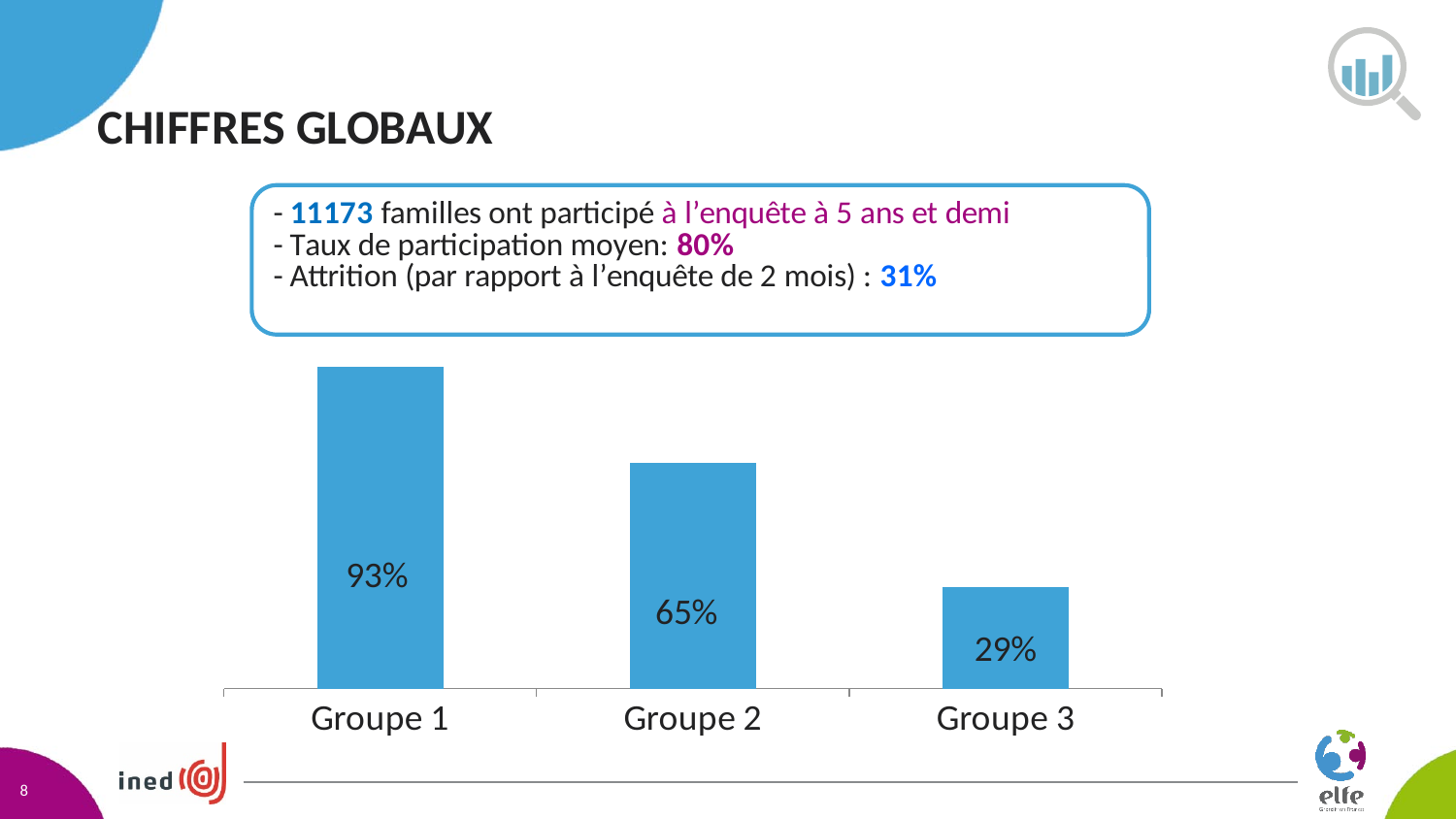
What is the difference between the values for Groupe 1 and Groupe 3? 64% What is the value for Groupe 1? 93% Which group has the highest value? Groupe 1 Which is larger, the value for Groupe 2 or the value for Groupe 3? Groupe 2 What is the value for Groupe 3? 29% What is the difference between the values for Groupe 2 and Groupe 3? 36% How many groups are shown in the chart? 3 What is the difference between the values for Groupe 1 and Groupe 2? 28% What is the value for Groupe 2? 65% Which group has the lowest value? Groupe 3 Do the values rise or fall from Groupe 1 to Groupe 3? Fall What kind of chart is shown on the slide? Bar chart